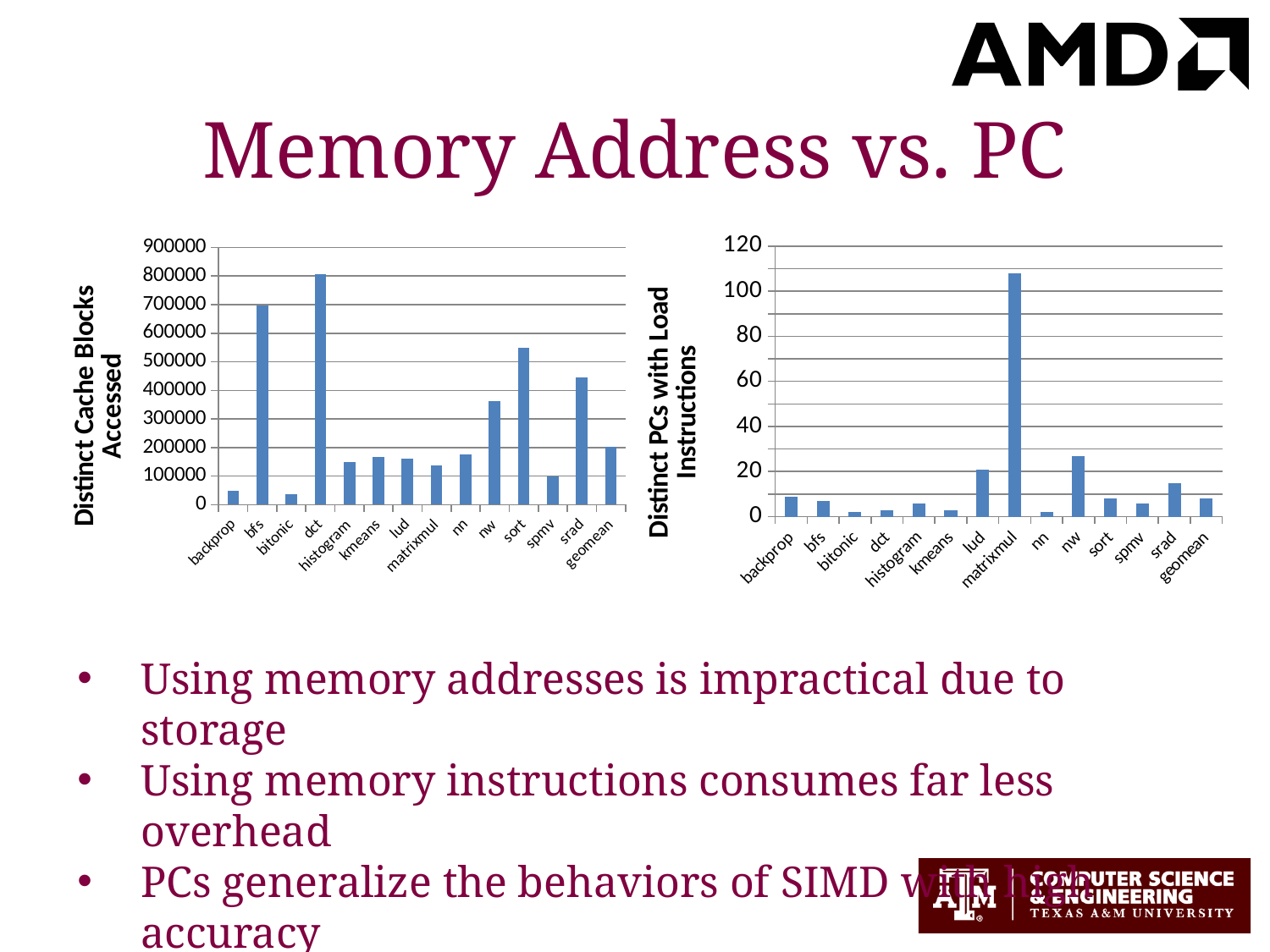
What type of chart is the left chart (Distinct Cache Blocks Accessed)? bar chart In the right chart (Distinct PCs with Load Instructions), which is larger, the value for nw or the value for lud? nw What is the y-axis label of the right chart? Distinct PCs with Load Instructions In the right chart (Distinct PCs with Load Instructions), is the value for lud greater or less than 40? less How many benchmark categories are shown on the x axis of the left chart (Distinct Cache Blocks Accessed)? 14 In the left chart (Distinct Cache Blocks Accessed), is the value for sort greater or less than 500000? greater In the left chart (Distinct Cache Blocks Accessed), which is larger, the value for bfs or the value for sort? bfs In the right chart (Distinct PCs with Load Instructions), is the value for matrixmul greater or less than 100? greater In the right chart (Distinct PCs with Load Instructions), which benchmark has the highest value? matrixmul In the left chart (Distinct Cache Blocks Accessed), which benchmark has the highest value? dct In the left chart (Distinct Cache Blocks Accessed), which benchmark has the lowest value? bitonic